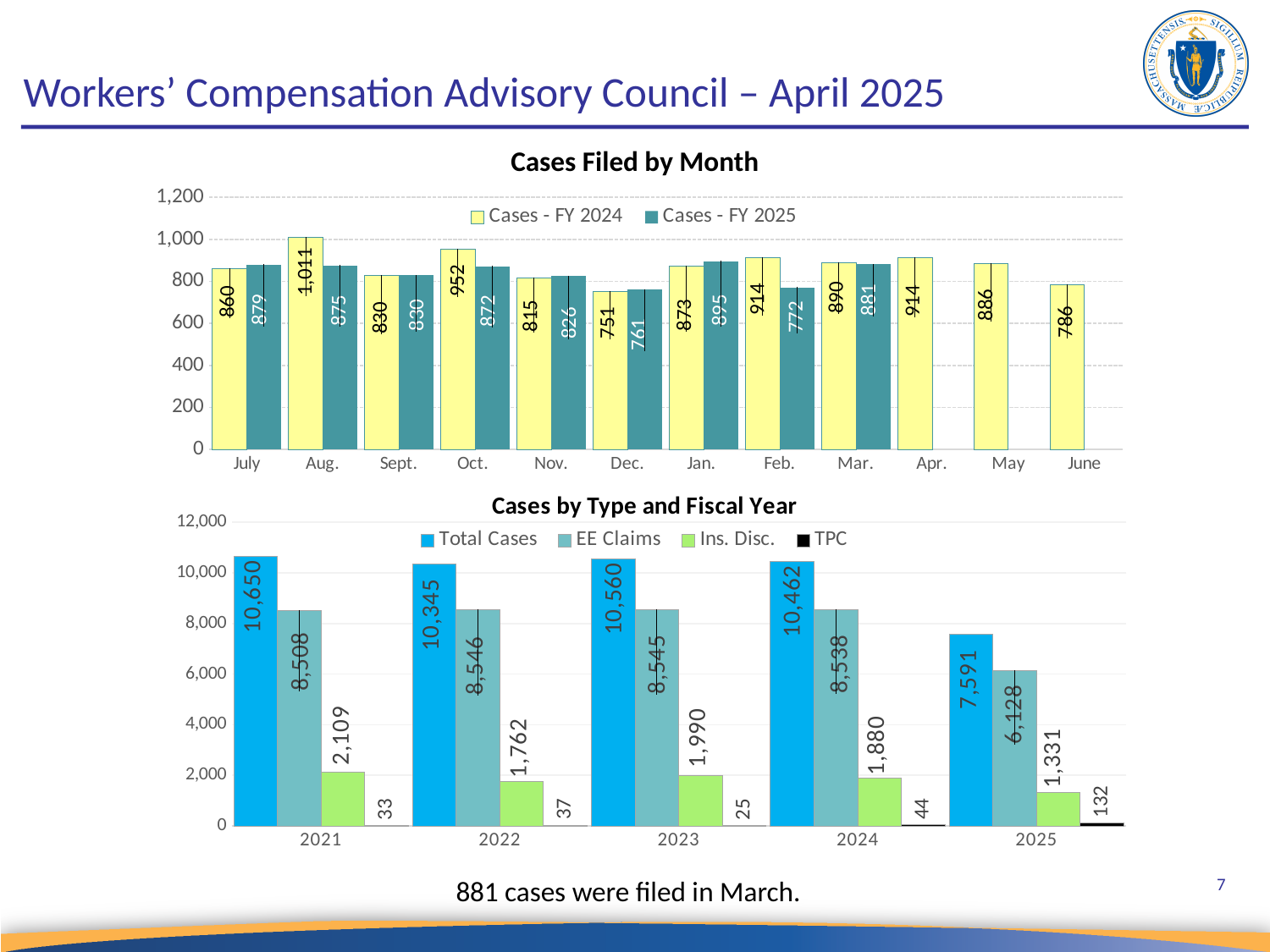
In the 'Cases Filed by Month' chart, which month has the lowest FY 2025 value? Dec. In the 'Cases by Type and Fiscal Year' chart, which year has the lowest Total Cases value? 2025 In the 'Cases Filed by Month' chart, what is the difference between the FY 2024 and FY 2025 values for February? 142 In the 'Cases by Type and Fiscal Year' chart, how many series does the legend list? 4 In the 'Cases by Type and Fiscal Year' chart, what is the TPC value for 2025? 132 In the 'Cases Filed by Month' chart, how many cases were filed in March for FY 2025? 881 In the 'Cases by Type and Fiscal Year' chart, what is the Total Cases value for 2023? 10,560 In the 'Cases Filed by Month' chart, how many series does the legend list? 2 In the 'Cases Filed by Month' chart, which is larger for October: FY 2024 or FY 2025? FY 2024 What type of chart is 'Cases by Type and Fiscal Year'? Bar chart In the 'Cases Filed by Month' chart, how many cases were filed in August for FY 2024? 1,011 In the 'Cases Filed by Month' chart, which month has the highest FY 2024 value? Aug.